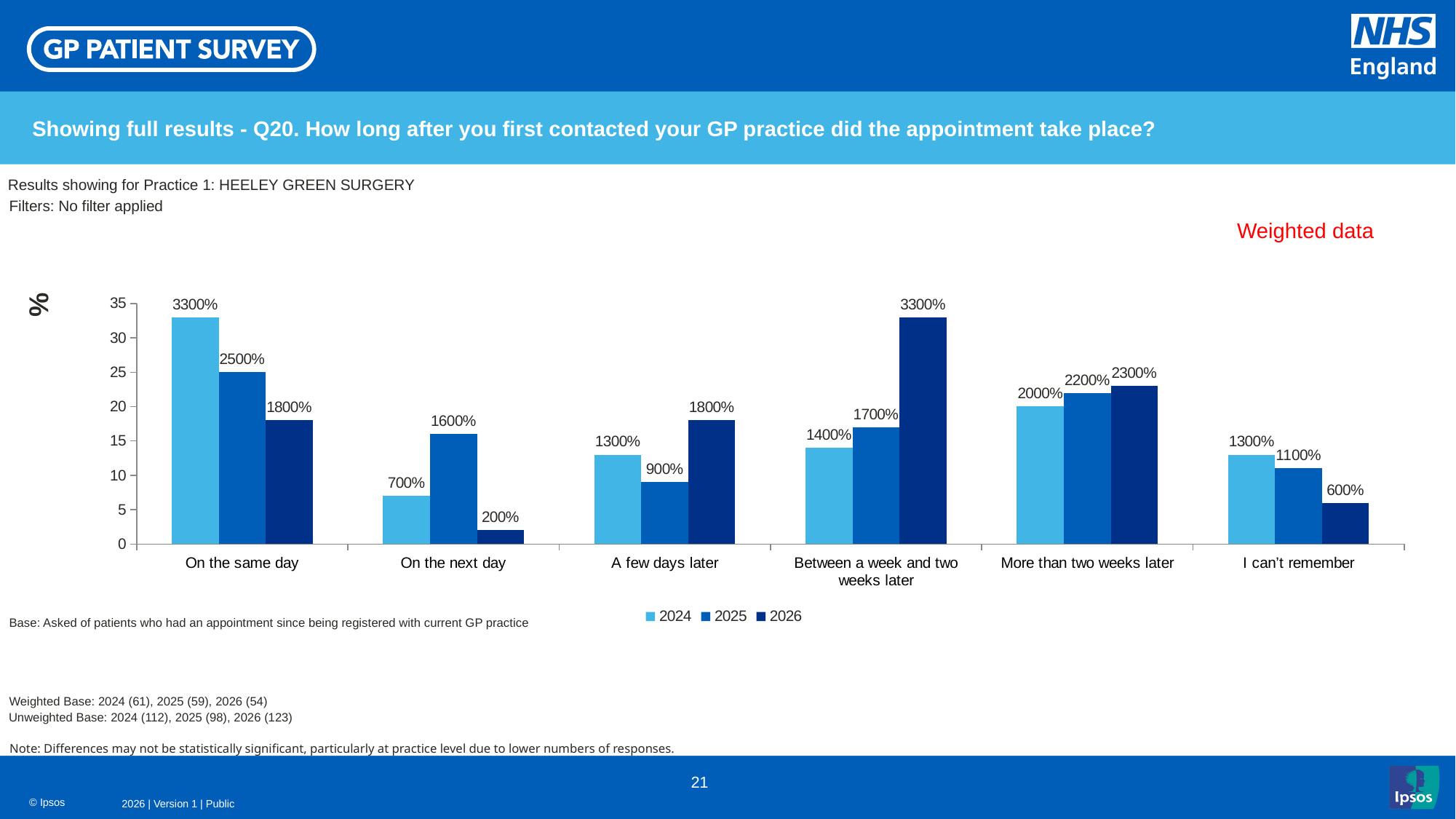
What is the 2025 value for 'I can't remember'? 1100% What kind of chart is shown on the slide? Bar chart How many categories are shown on the x axis? 6 What is the 2026 value for 'Between a week and two weeks later'? 3300% Which category has the highest 2024 value? On the same day Which category has the lowest 2026 value? On the next day Which is larger: the 2025 value for 'On the next day' or the 2025 value for 'A few days later'? On the next day What is the 2024 value for 'On the same day'? 3300% Do the values for 'On the same day' rise or fall from 2024 to 2026? Fall What is the difference between the 2024 and 2026 values for 'On the same day'? 1500% How many series does the legend list? 3 Is the 2026 value for 'More than two weeks later' greater or less than 20? greater